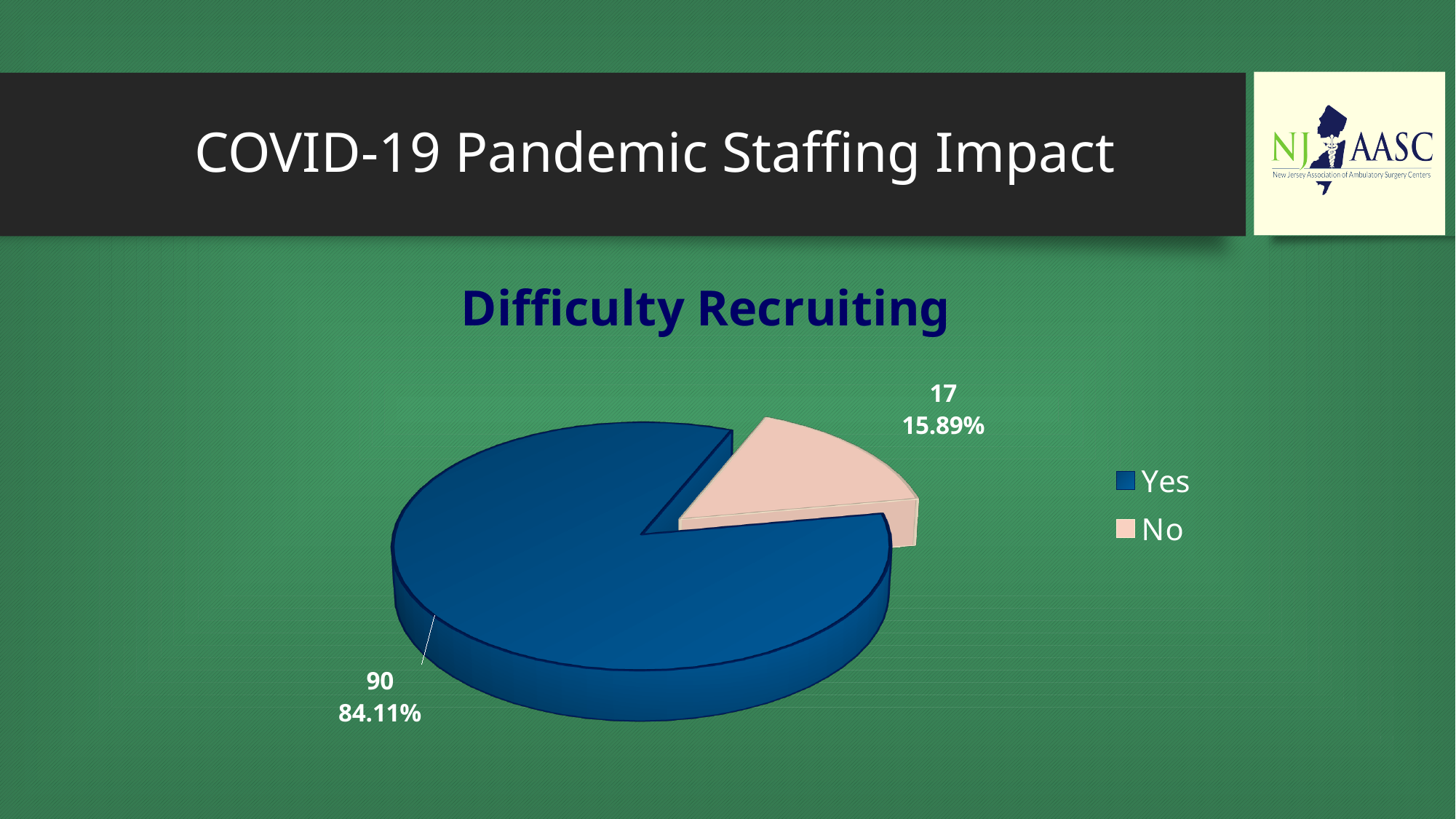
What type of chart is shown on the slide? Pie chart What is the title of the chart? Difficulty Recruiting Which is larger, the 'Yes' slice or the 'No' slice? Yes What is the count for the 'No' slice? 17 What is the count for the 'Yes' slice? 90 What is the difference between the 'Yes' count and the 'No' count? 73 What is the total of the two slice counts? 107 What percentage share does the 'No' slice represent? 15.89% How many categories does the pie chart have? 2 What percentage share does the 'Yes' slice represent? 84.11% Which category has the smallest slice? No Which category has the largest slice? Yes